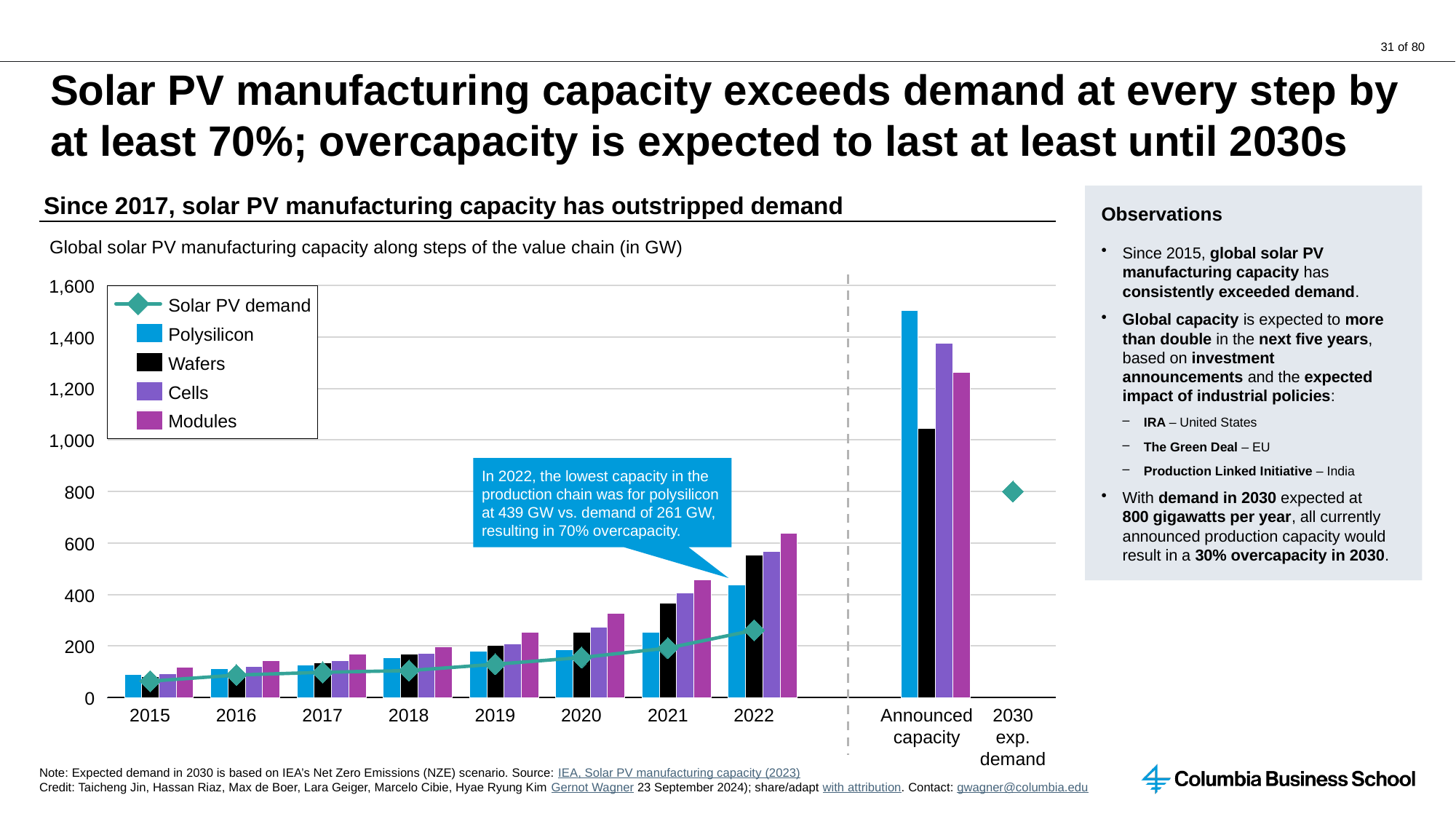
Which value chain step had the lowest manufacturing capacity in 2022? Polysilicon According to the callout, what was the polysilicon manufacturing capacity in 2022? 439 GW How many series does the chart legend list? 5 Is the Modules value for 2022 greater or less than 600? greater Does the Polysilicon capacity rise or fall from 2015 to 2022? Rises How many categories are shown along the x axis of the chart? 10 Which value chain step has the highest bar in the Announced capacity category? Polysilicon What is the difference between 2022 polysilicon capacity and 2022 solar PV demand, as given in the callout? 178 GW Is the Announced capacity value for Polysilicon greater or less than 1,400? greater What kind of chart is shown on the slide? Combination bar and line chart In 2021, which is larger: the Modules capacity or the Polysilicon capacity? Modules According to the callout, what was solar PV demand in 2022? 261 GW